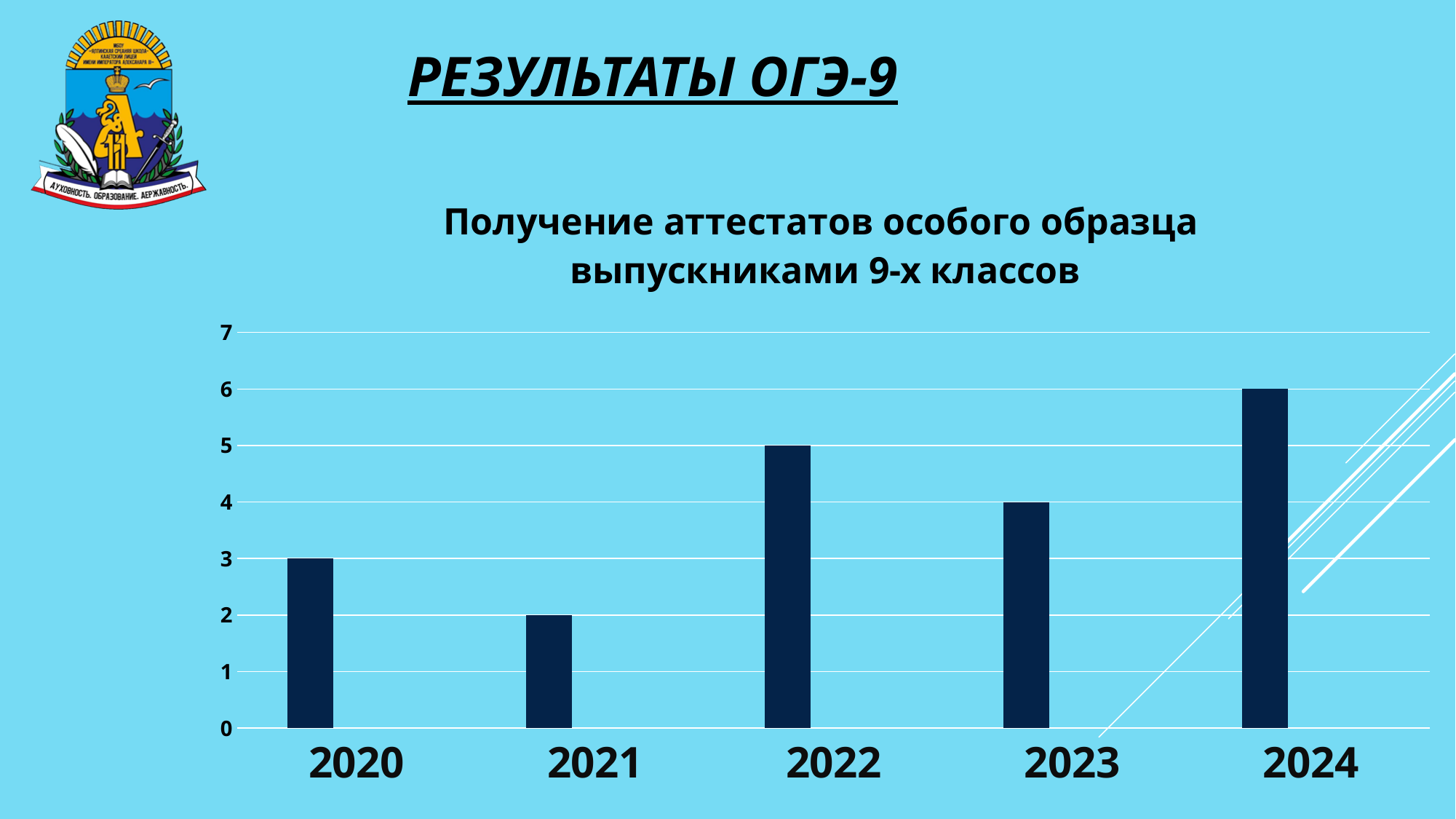
What is the title of the chart? Получение аттестатов особого образца выпускниками 9-х классов What is the value for 2022? 5 Which year has the lowest value? 2021 What is the value for 2024? 6 How many years are shown on the x axis? 5 What kind of chart is shown on the slide? bar chart What is the value for 2020? 3 What is the value for 2021? 2 Which year has the highest value? 2024 Which is larger, the value for 2022 or the value for 2023? 2022 What is the difference between the values for 2024 and 2023? 2 Is the value for 2024 greater or less than 5? greater